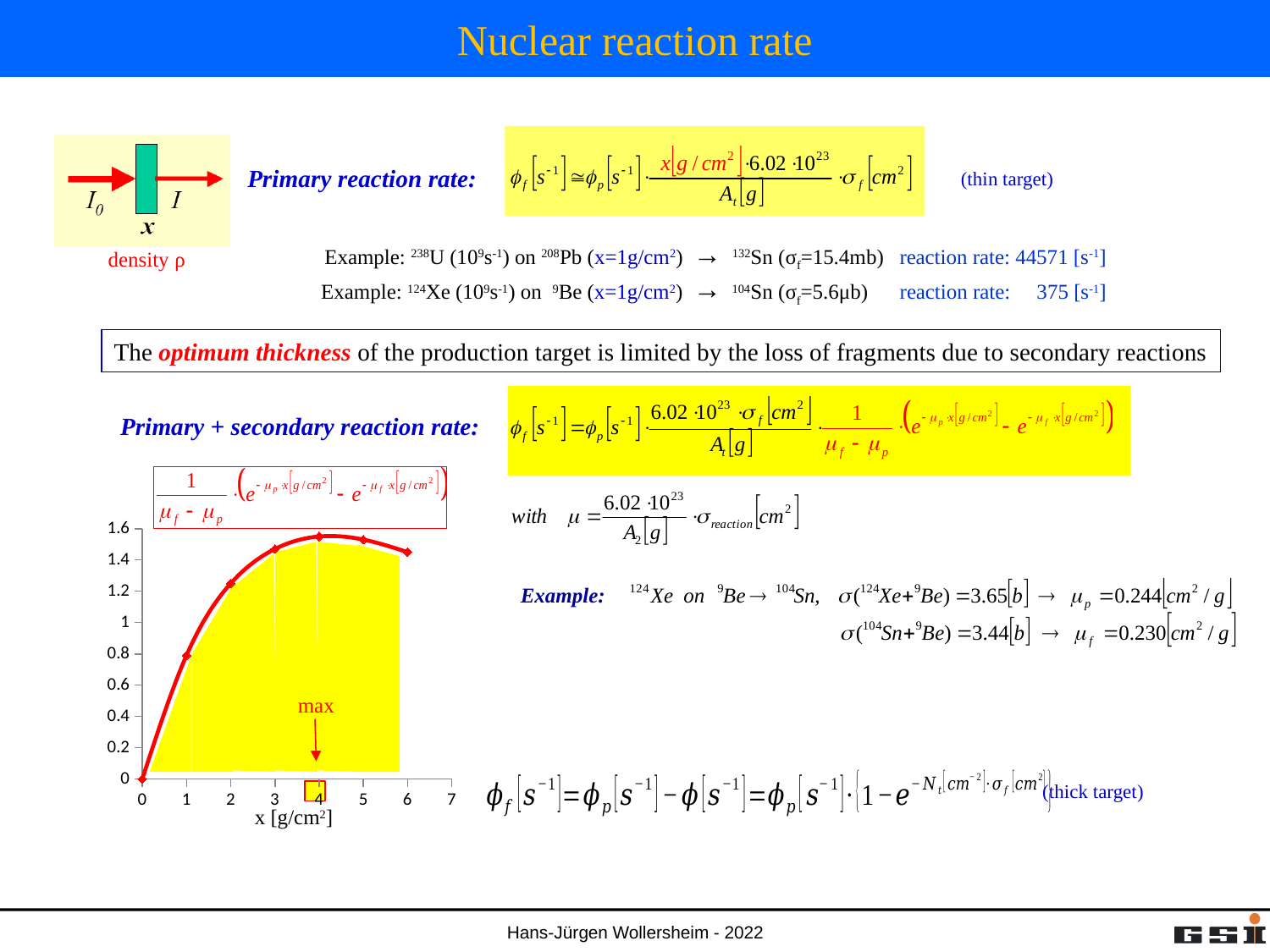
Do the plotted values rise or fall as x goes from 0 to 4? rise Is the plotted value at x = 4 greater or less than 1.4? greater Is the plotted value at x = 2 greater or less than 1? greater At which x value is the curve marked as its maximum? 4 What is the label of the x axis of the chart? x [g/cm2] Is the plotted value at x = 1 greater or less than 1? less What kind of chart is shown on the slide? line chart How many data points are marked on the curve? 7 What is the plotted value at x = 0? 0 Do the plotted values rise or fall as x goes from 4 to 6? fall